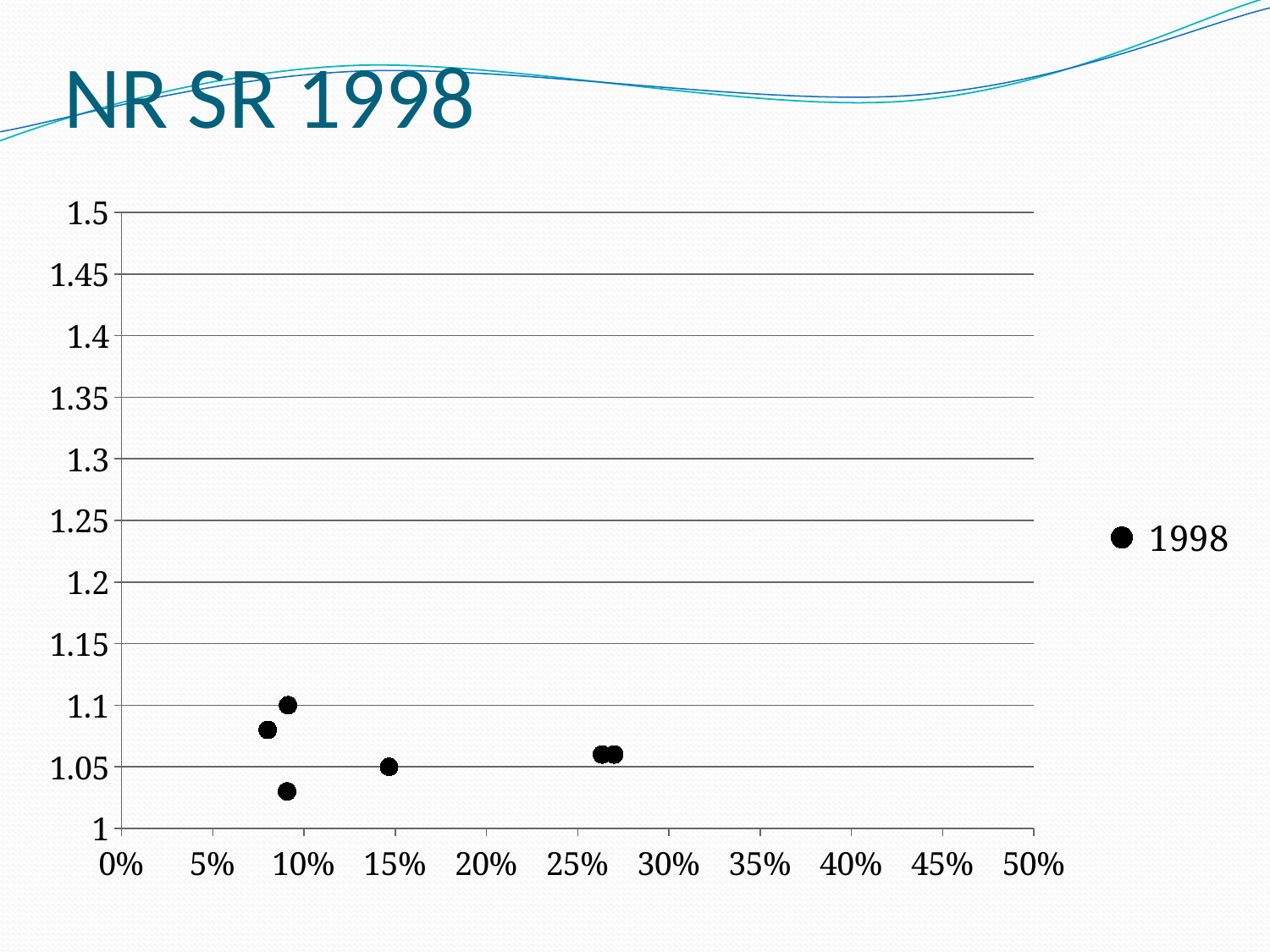
How many data points are plotted on the chart? 6 Is the largest x-axis position of any plotted point greater or less than 30%? less Is the highest plotted value on the y axis greater or less than 1.15? less Is the y value of the point plotted near 8% on the x axis greater or less than 1.05? greater What is the title of the slide containing the chart? NR SR 1998 What is the legend entry for the plotted series? 1998 What kind of chart is shown on the slide? scatter chart How many data points lie between 25% and 30% on the x axis? 2 How many series does the legend list? 1